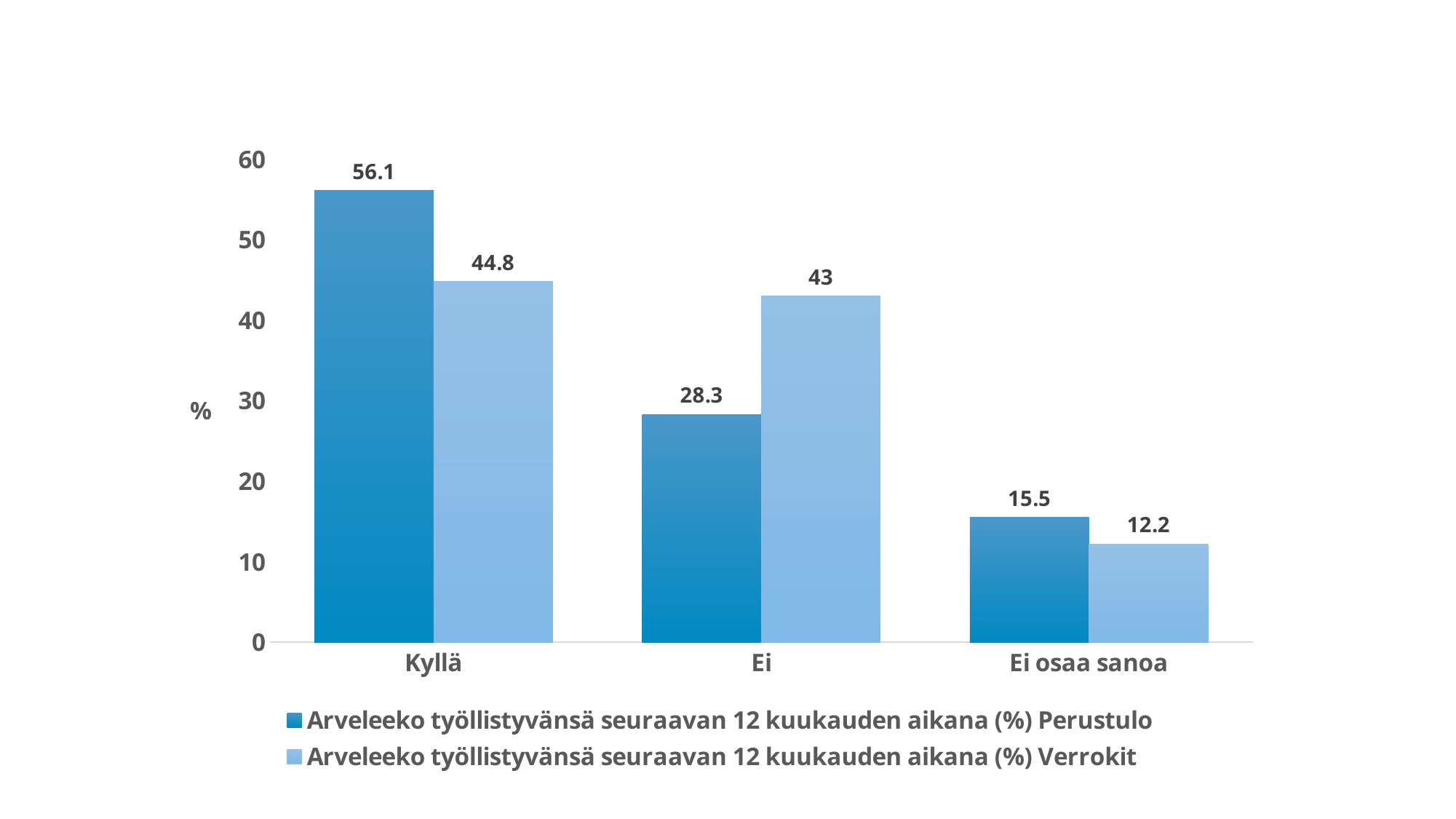
What is the value for Ei in the Verrokit series? 43 What is the difference between the Verrokit and Perustulo values for Ei? 14.7 What is the value for Ei osaa sanoa in the Verrokit series? 12.2 For Ei, which series has the larger value, Perustulo or Verrokit? Verrokit How many categories are shown on the x axis? 3 What is the value for Kyllä in the Perustulo series? 56.1 Which category has the highest value in the Perustulo series? Kyllä What is the difference between the Perustulo and Verrokit values for Kyllä? 11.3 What kind of chart is shown on the slide? bar chart Which category has the lowest value in the Verrokit series? Ei osaa sanoa Is the Perustulo value for Ei greater or less than 30? less How many series does the legend list? 2